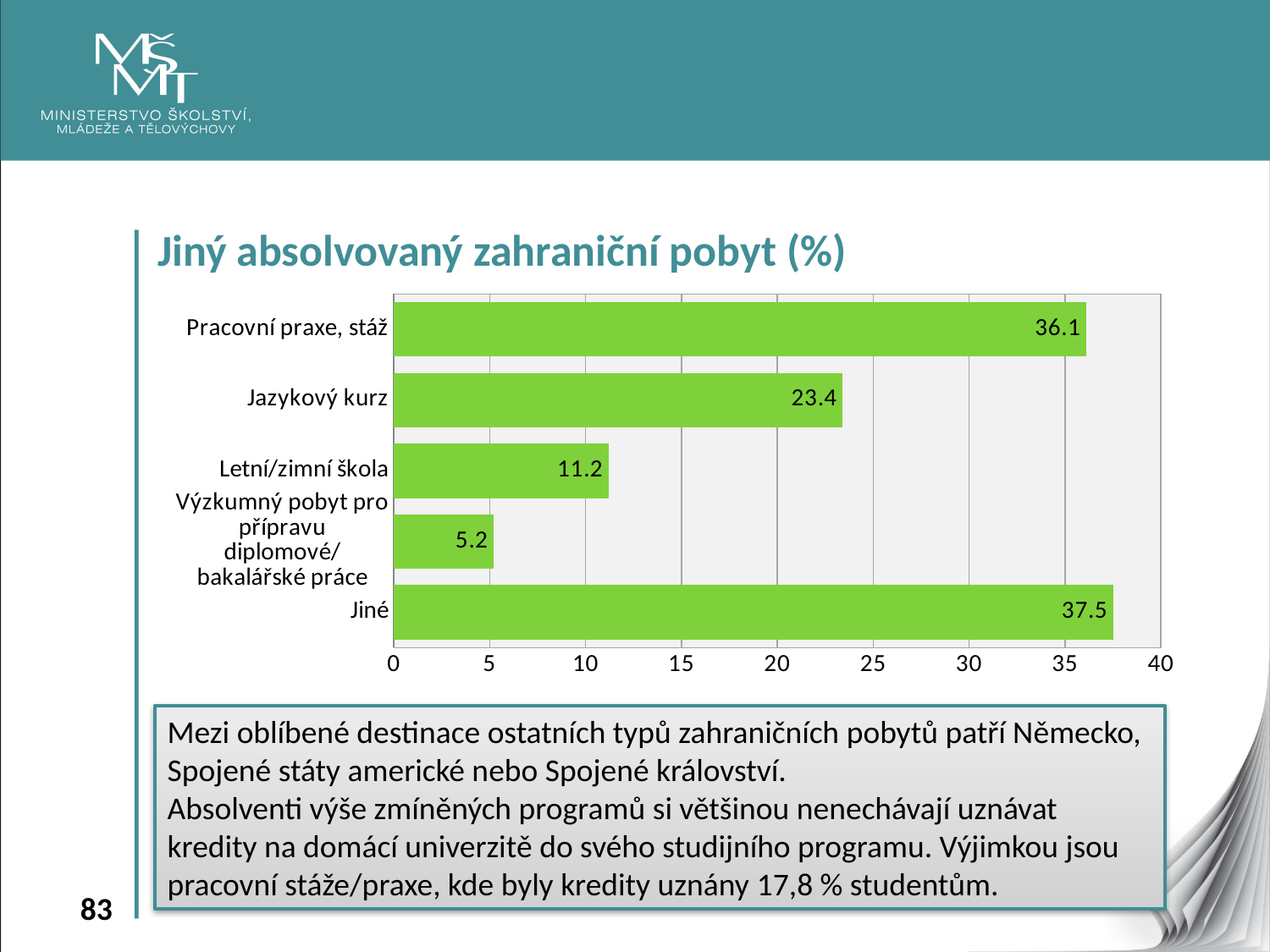
What is the value for Jazykový kurz? 23.4 Which category has the highest value? Jiné What is the difference between the values for Pracovní praxe, stáž and Jazykový kurz? 12.7 What is the value for Jiné? 37.5 What kind of chart is shown on the slide? bar chart What is the title of the chart? Jiný absolvovaný zahraniční pobyt (%) Which category has the lowest value? Výzkumný pobyt pro přípravu diplomové/bakalářské práce How many categories are shown in the chart? 5 Which is larger, the value for Jazykový kurz or the value for Letní/zimní škola? Jazykový kurz What is the value for Výzkumný pobyt pro přípravu diplomové/bakalářské práce? 5.2 What is the value for Pracovní praxe, stáž? 36.1 What is the value for Letní/zimní škola? 11.2